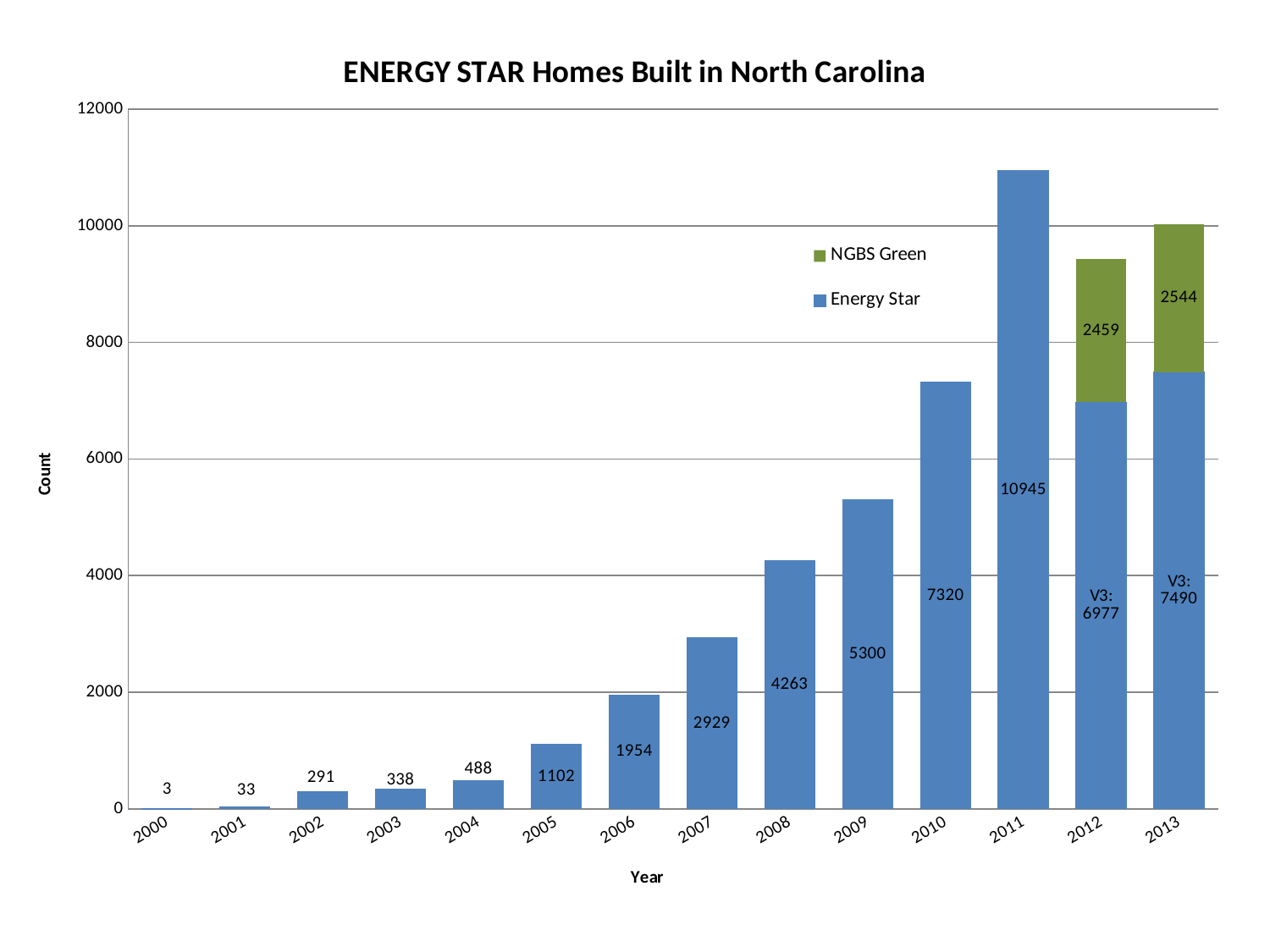
How many ENERGY STAR homes were built in North Carolina in 2011 according to the chart? 10945 What is the Energy Star value labeled for 2012? V3: 6977 Which year has the highest Energy Star count? 2011 What kind of chart is shown on the slide? Bar chart How many years are shown on the x axis? 14 Which year has a larger Energy Star count, 2007 or 2008? 2008 What is the total height of the stacked bar for 2012 (Energy Star plus NGBS Green)? 9436 Which year has the lowest Energy Star count? 2000 What is the NGBS Green value for 2013? 2544 How many series does the legend list? 2 Do the Energy Star counts rise or fall from 2000 to 2011? Rise What is the difference between the Energy Star counts for 2010 and 2009? 2020